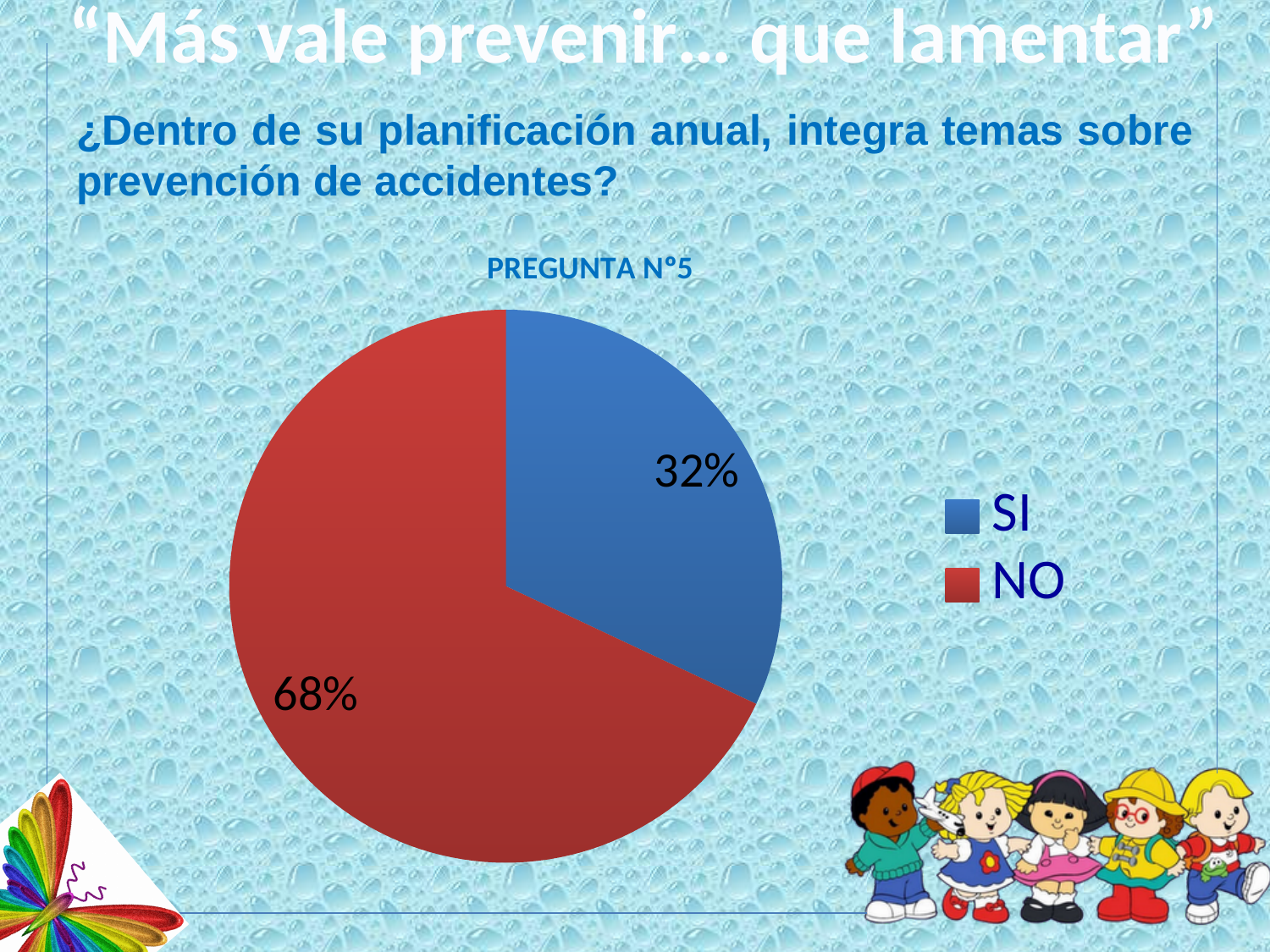
What share of the pie does the SI slice represent? 32% What percentage of the pie is labelled NO? 68% How many slices does the pie chart have? 2 How many entries does the legend list? 2 What is the chart's title? PREGUNTA N°5 What kind of chart is shown on the slide? pie chart What colour is the NO slice? red Which category has the smallest share of the pie? SI Which slice is larger, SI or NO? NO What is the difference in percentage points between the NO and SI slices? 36 What percentage of the pie is labelled SI? 32% Which category has the largest share of the pie? NO